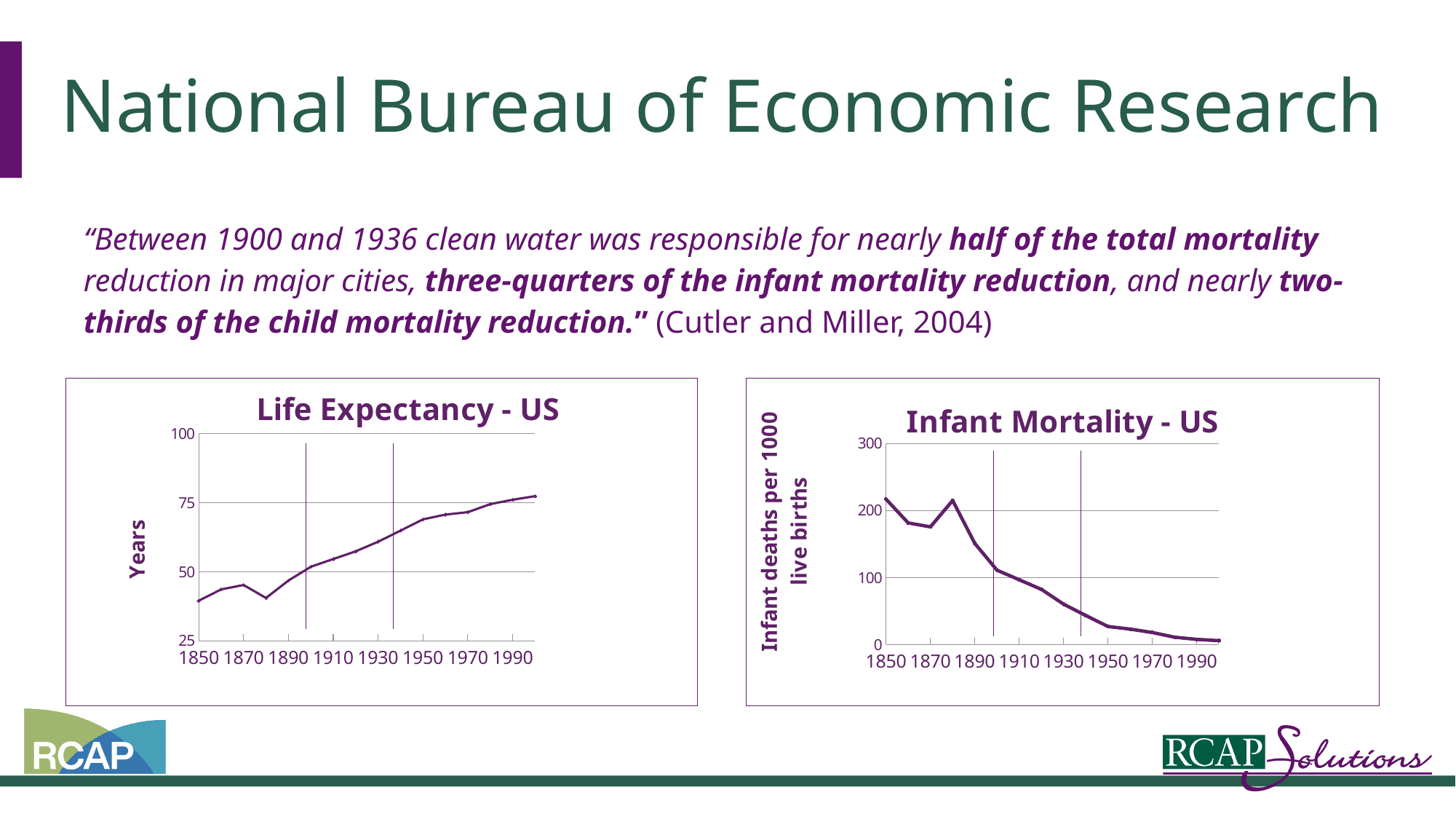
What is the y-axis label of the "Infant Mortality - US" chart? Infant deaths per 1000 live births In the "Life Expectancy - US" chart, do the values generally rise or fall from 1850 to 1990? rise In the "Infant Mortality - US" chart, do the values generally rise or fall from 1850 to 1990? fall In the "Life Expectancy - US" chart, is the value for 1850 greater or less than 50? less In the "Infant Mortality - US" chart, which is larger, the value for 1870 or the value for 1950? 1870 In the "Infant Mortality - US" chart, is the value for 1850 greater or less than 200? greater What kind of chart is the "Life Expectancy - US" chart? line chart What kind of chart is the "Infant Mortality - US" chart? line chart What is the y-axis label of the "Life Expectancy - US" chart? Years In the "Infant Mortality - US" chart, is the value for 1990 greater or less than 100? less In the "Life Expectancy - US" chart, which is larger, the value for 1850 or the value for 1990? 1990